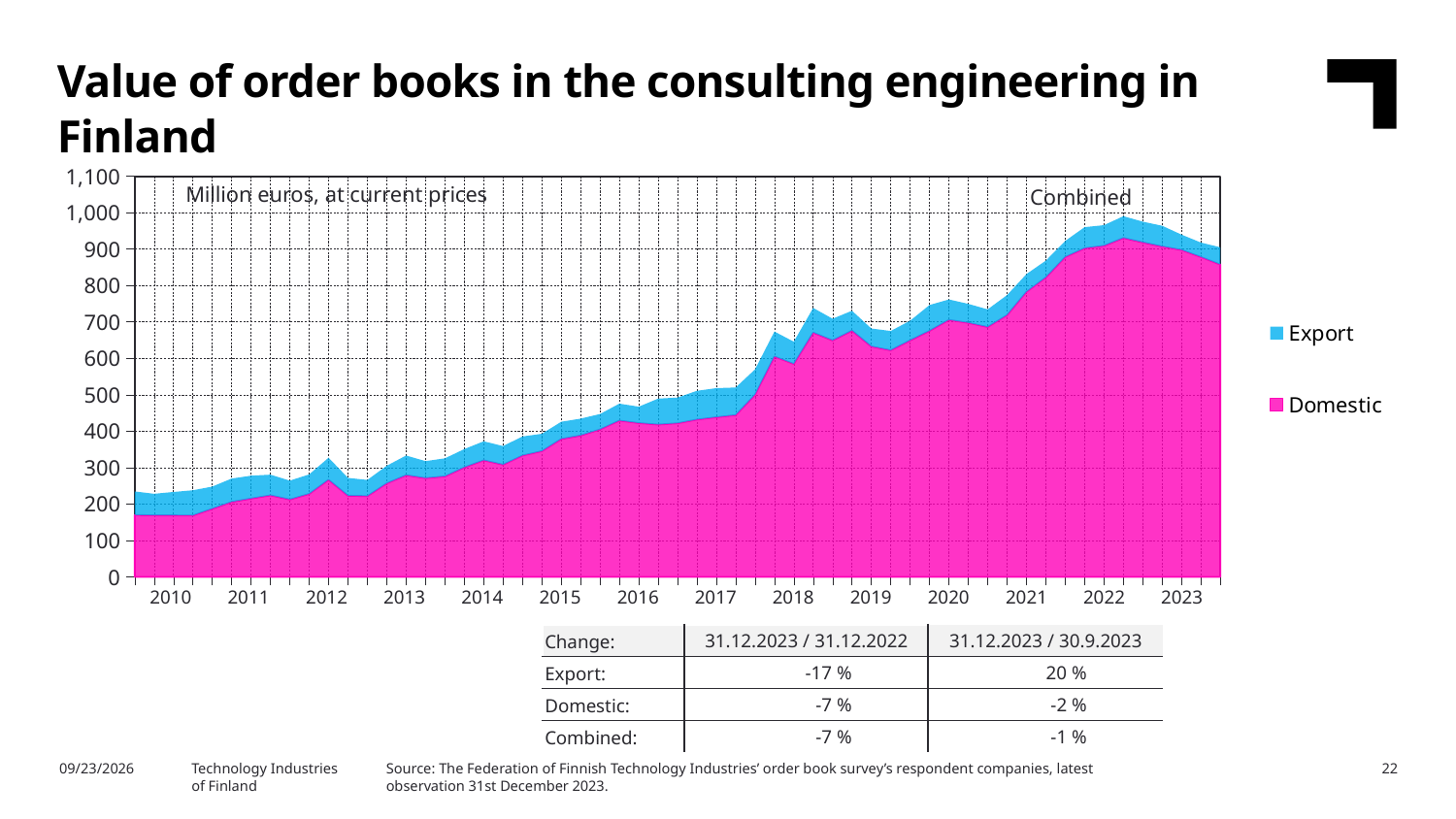
Is the combined value at the end of 2023 greater or less than 800? greater Which two series are listed in the legend? Export and Domestic Is the Domestic value at the start of 2010 greater or less than 200? less In which year does the combined value of order books reach its highest point? 2022 What unit is stated for the values in the chart? Million euros, at current prices Is the combined value at the start of 2010 greater or less than 300? less What kind of chart is shown on the slide? Stacked area chart How many series does the legend list? 2 How many years are labelled on the x axis? 14 Does the combined value of order books generally rise or fall from 2010 to 2022? Rise In which year is the combined value of order books at its lowest? 2010